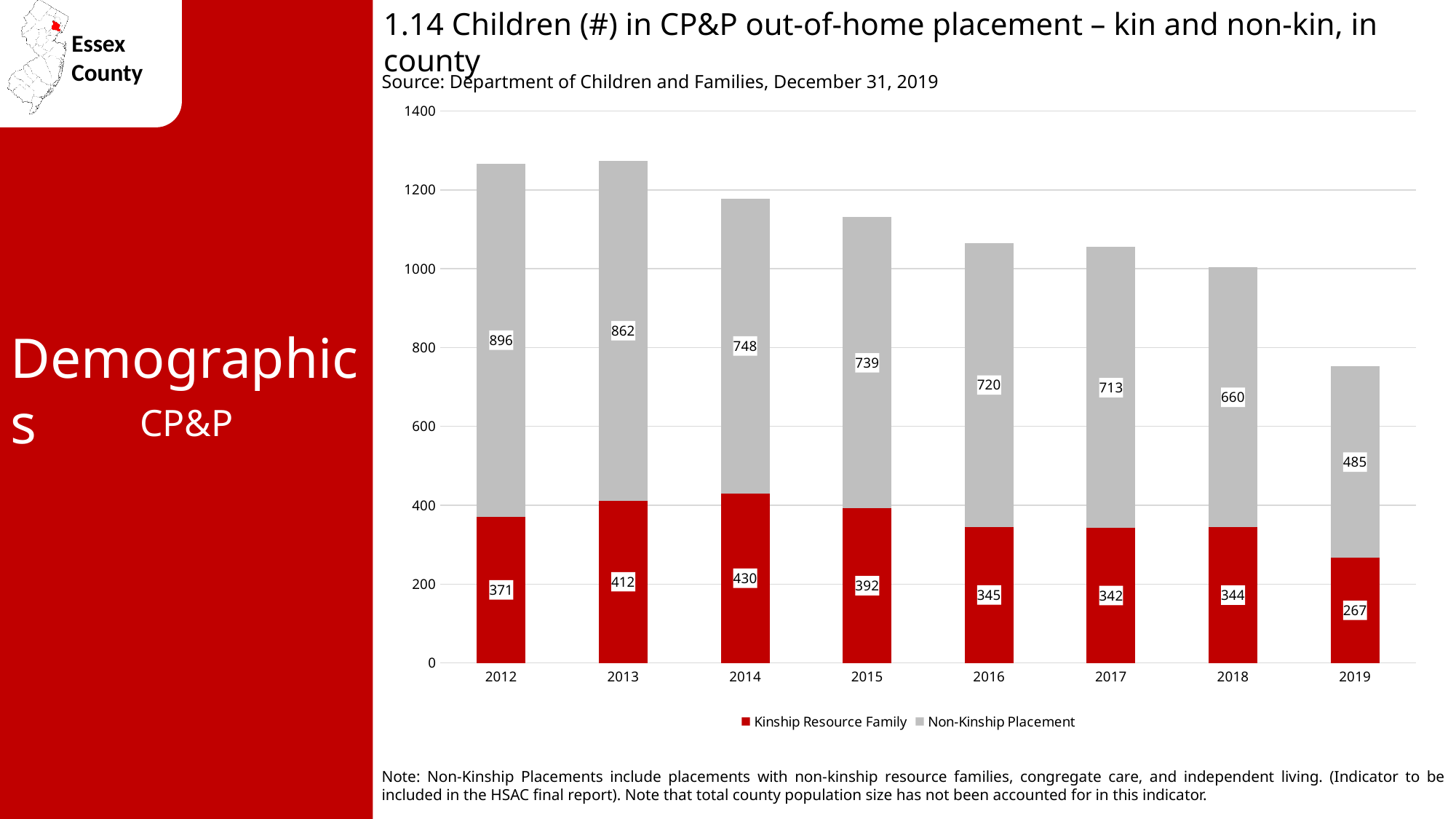
How many series does the legend list? 2 Which is larger, the Kinship Resource Family value for 2016 or for 2018? 2018 What is the difference between the Non-Kinship Placement values for 2012 and 2013? 34 What kind of chart is shown? stacked bar chart What is the Non-Kinship Placement value for 2019? 485 Which year has the highest Non-Kinship Placement value? 2012 What is the Kinship Resource Family value for 2014? 430 Which colour represents Kinship Resource Family in the legend? red How many years are shown on the x axis? 8 Which year has the lowest Kinship Resource Family value? 2019 Is the total stacked bar for 2019 greater or less than 800? less What is the total of the stacked bar for 2015? 1131